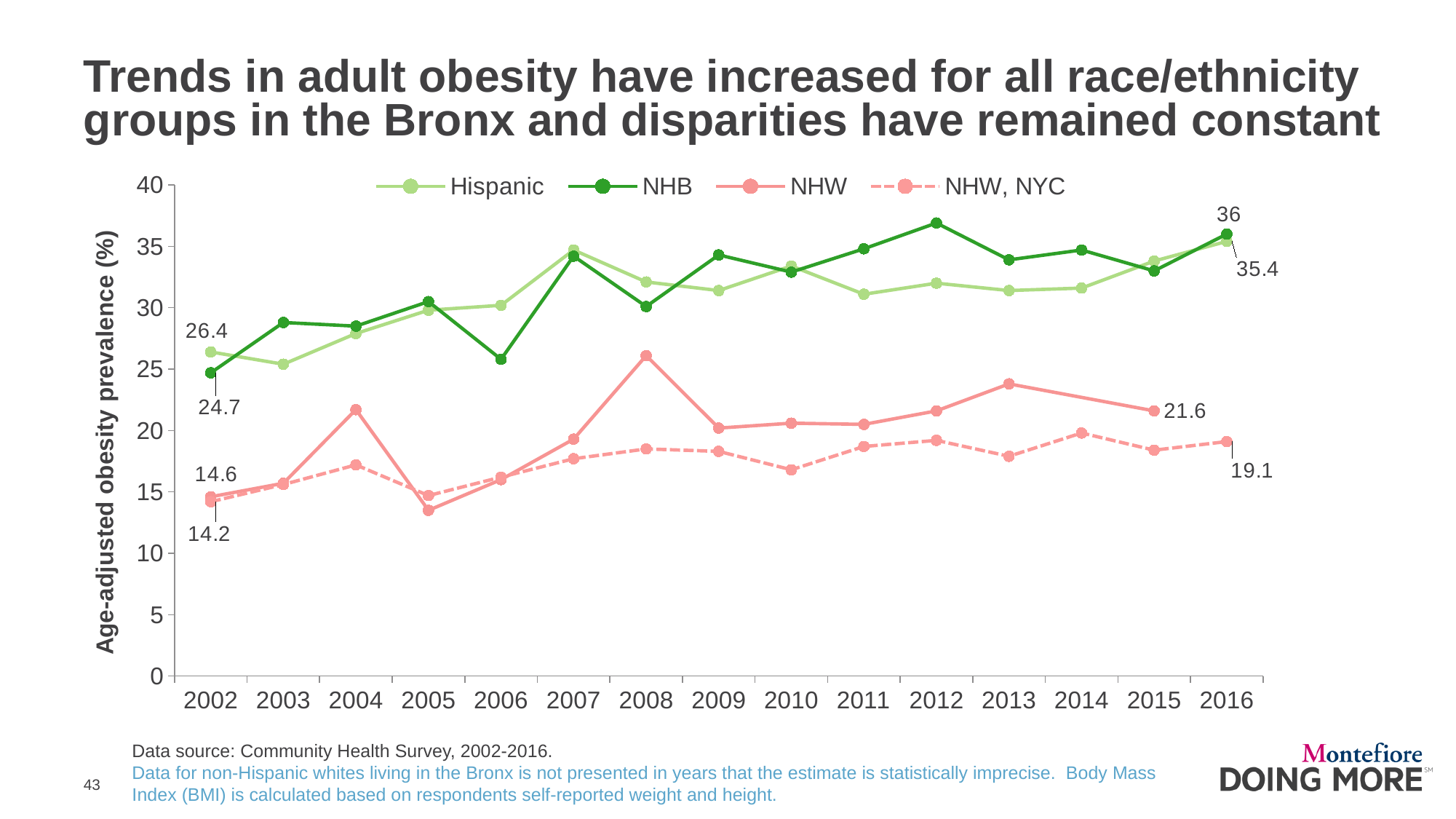
What is the age-adjusted obesity prevalence for NHB adults in 2002? 24.7 What kind of chart is shown on the slide? line chart What is the age-adjusted obesity prevalence for NHW, NYC in 2016? 19.1 By how much did the NHB obesity prevalence increase from 2002 to 2016? 11.3 What is the title of the y axis? Age-adjusted obesity prevalence (%) How many series does the legend list? 4 What is the age-adjusted obesity prevalence for Hispanic adults in 2002? 26.4 What is the age-adjusted obesity prevalence for NHB adults in 2016? 36 How many years are shown on the x axis? 15 What is the age-adjusted obesity prevalence for Hispanic adults in 2016? 35.4 Which group had the higher obesity prevalence in 2002, Hispanic or NHB? Hispanic Is the value for NHW in 2008 greater or less than 25? greater